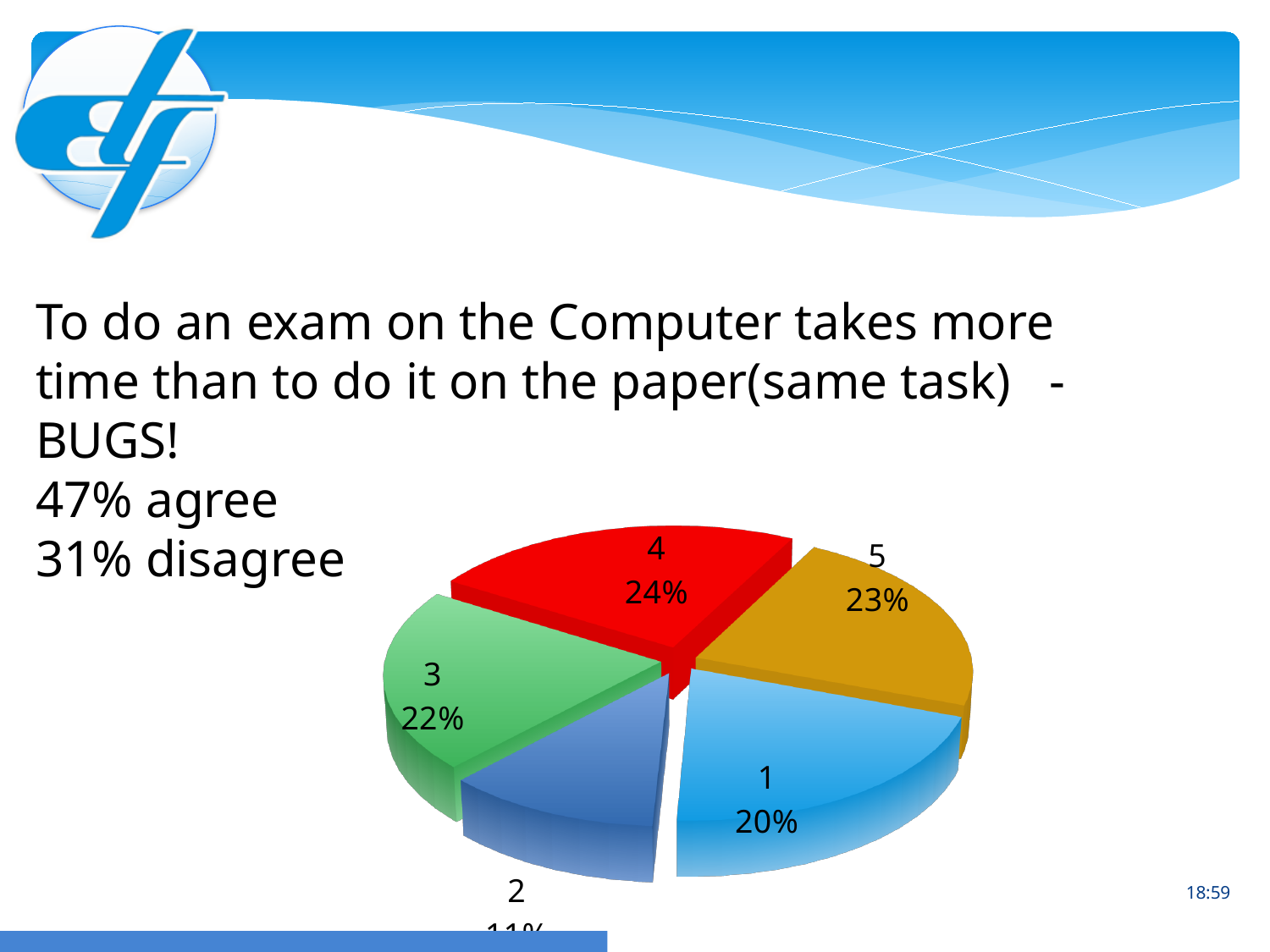
What is the difference in percentage points between slice 4 and slice 1? 4 Which slice has the smallest share of the pie chart? 2 What percentage does slice 3 represent in the pie chart? 22% What percentage does slice 4 represent in the pie chart? 24% What kind of chart is shown on the slide? pie chart Which slice is larger in the pie chart, slice 4 or slice 1? 4 What percentage does slice 1 represent in the pie chart? 20% What colour is slice 4 in the pie chart? red What colour is slice 3 in the pie chart? green Which slice has the largest share of the pie chart? 4 How many slices does the pie chart have? 5 What percentage does slice 5 represent in the pie chart? 23%